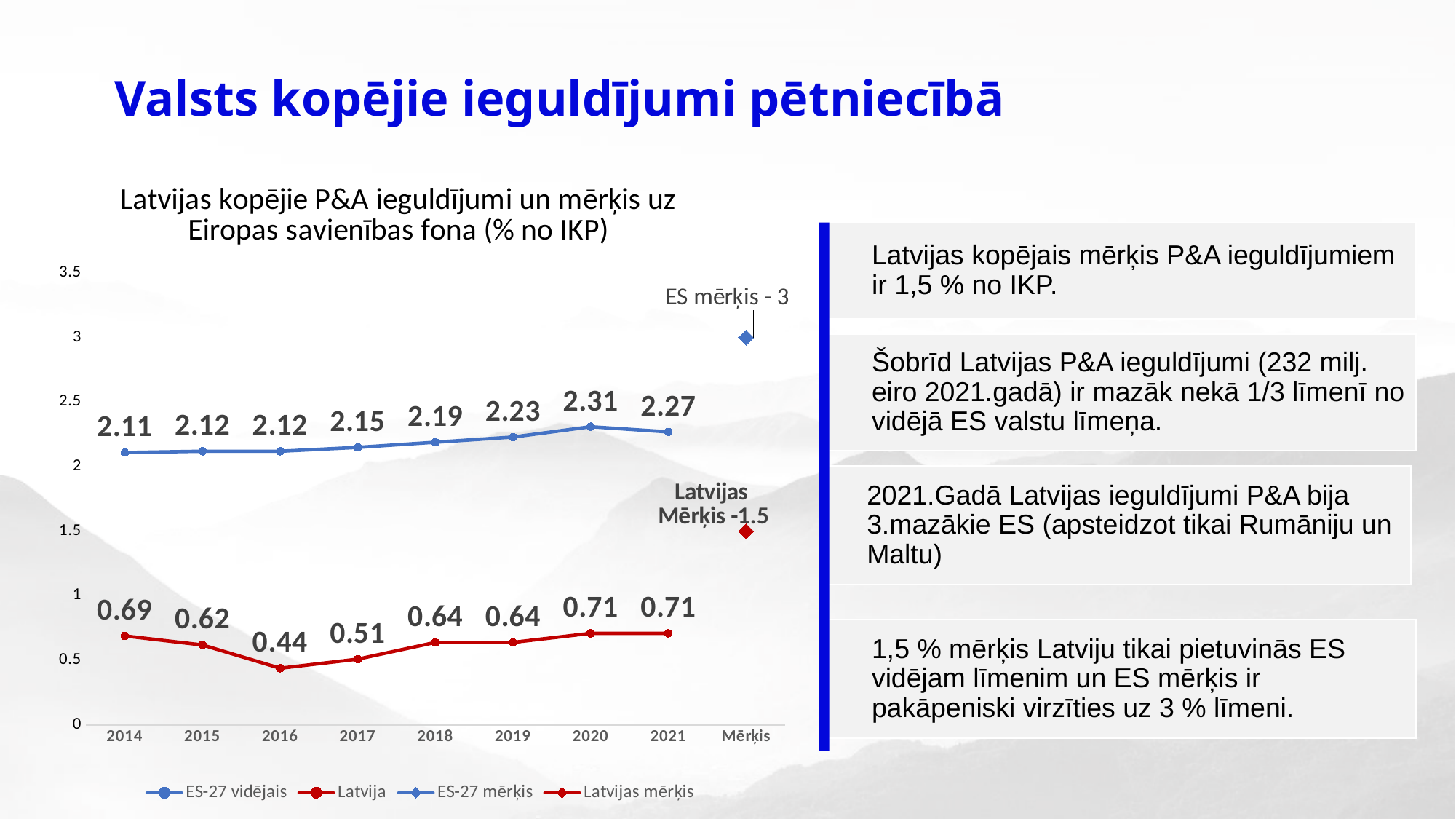
What is the value for ES-27 vidējais in 2014? 2.11 What is the difference between the ES-27 vidējais value and the Latvija value in 2021? 1.56 Is the ES-27 vidējais value in 2018 greater or less than 2? greater What kind of chart is shown on the slide? line chart What is the value for Latvija in 2016? 0.44 In which year is the Latvija series at its lowest? 2016 In which year is the ES-27 vidējais series at its highest? 2020 What is the value for ES-27 vidējais in 2020? 2.31 Which is larger, the Latvija value in 2014 or in 2017? 2014 How many series does the legend list? 4 What is the difference between the Latvija values in 2020 and 2016? 0.27 What is the value of the ES mērķis marker? 3